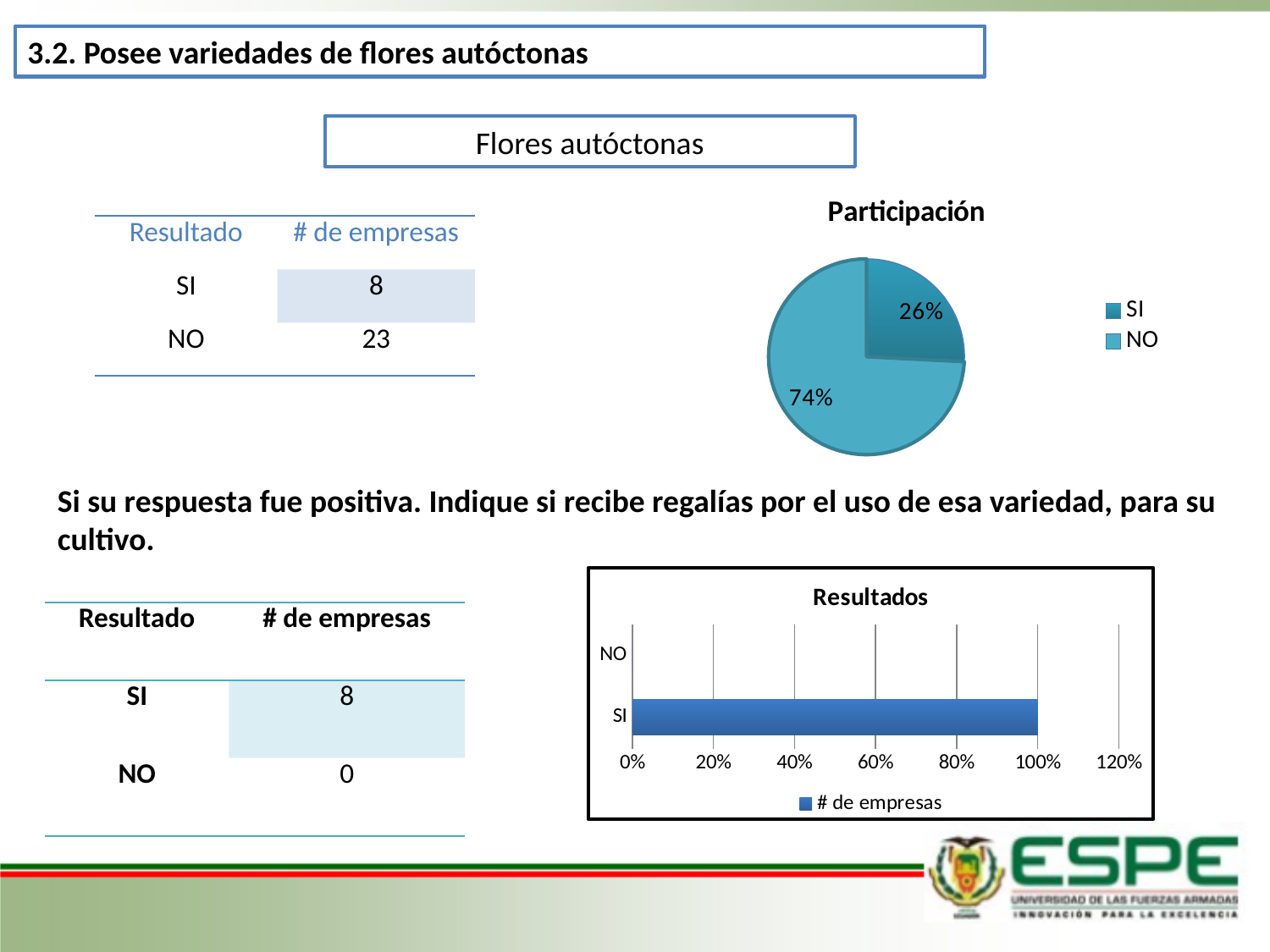
In the 'Participación' pie chart, what is the difference in percentage points between the NO and SI slices? 48% In the 'Participación' pie chart, what share does the NO slice have? 74% In the 'Participación' pie chart, which slice is the largest? NO What kind of chart is the 'Resultados' chart? Bar chart In the 'Resultados' bar chart, is the value for NO greater or less than 20%? less In the 'Resultados' bar chart, what is the value for SI? 100% How many entries does the legend of the 'Participación' chart list? 2 In the 'Resultados' bar chart, which category has the higher value, SI or NO? SI What kind of chart is the 'Participación' chart? Pie chart In the 'Participación' pie chart, what share does the SI slice have? 26% In the 'Participación' pie chart, which slice is the smallest? SI What series name is shown in the legend of the 'Resultados' bar chart? # de empresas